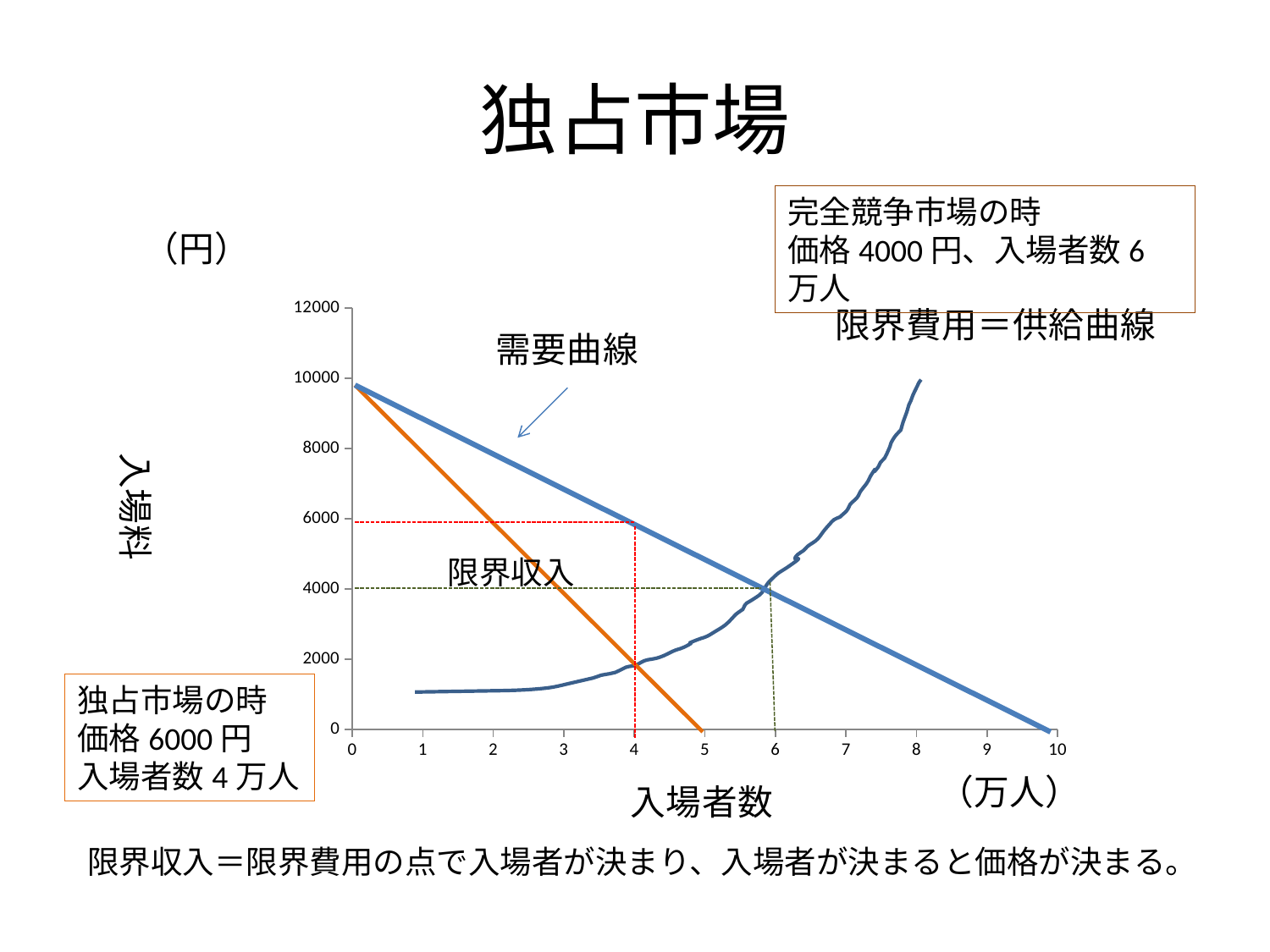
Is the value of the 需要曲線 at 入場者数 = 0 greater or less than 8000? greater What is the label of the vertical axis? 入場料 Does the 限界費用＝供給曲線 curve rise or fall as 入場者数 increases? rise Which is larger, the number of attendees in the monopoly market or in the perfectly competitive market? perfectly competitive market (完全競争市場) According to the slide, what is the price (価格) in the monopoly market (独占市場)? 6000円 According to the slide, what is the number of attendees (入場者数) in the perfectly competitive market (完全競争市場)? 6万人 Does the 需要曲線 (demand curve) rise or fall as 入場者数 increases? fall How many curves are plotted on the chart? 3 According to the slide, what is the number of attendees (入場者数) in the monopoly market (独占市場)? 4万人 According to the slide, what is the price (価格) in the perfectly competitive market (完全競争市場)? 4000円 What kind of chart is shown on the slide? line chart How much higher is the monopoly price than the perfectly competitive price? 2000円